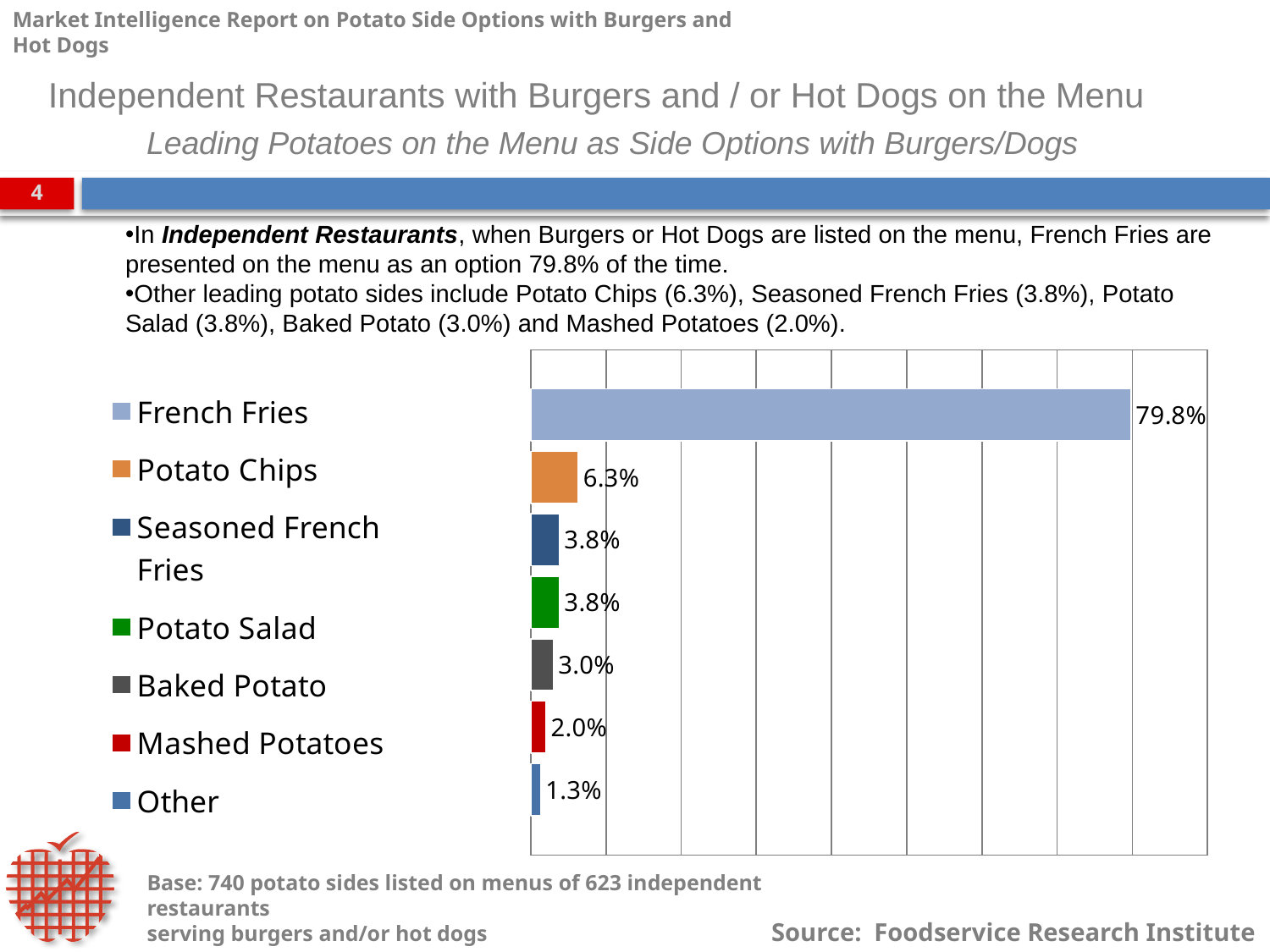
What is the difference in percentage points between French Fries and Potato Chips? 73.5 What percentage is shown for Baked Potato? 3.0% Which has a larger percentage, Potato Chips or Baked Potato? Potato Chips How many potato side categories are plotted in the chart? 7 What percentage is shown for Potato Chips? 6.3% Which potato side has the highest percentage? French Fries What type of chart is shown on the slide? Bar chart What percentage is shown for French Fries? 79.8% What is the difference in percentage points between Baked Potato and Mashed Potatoes? 1.0 Which potato side has the lowest percentage? Other What percentage is shown for Other? 1.3% What percentage is shown for Mashed Potatoes? 2.0%